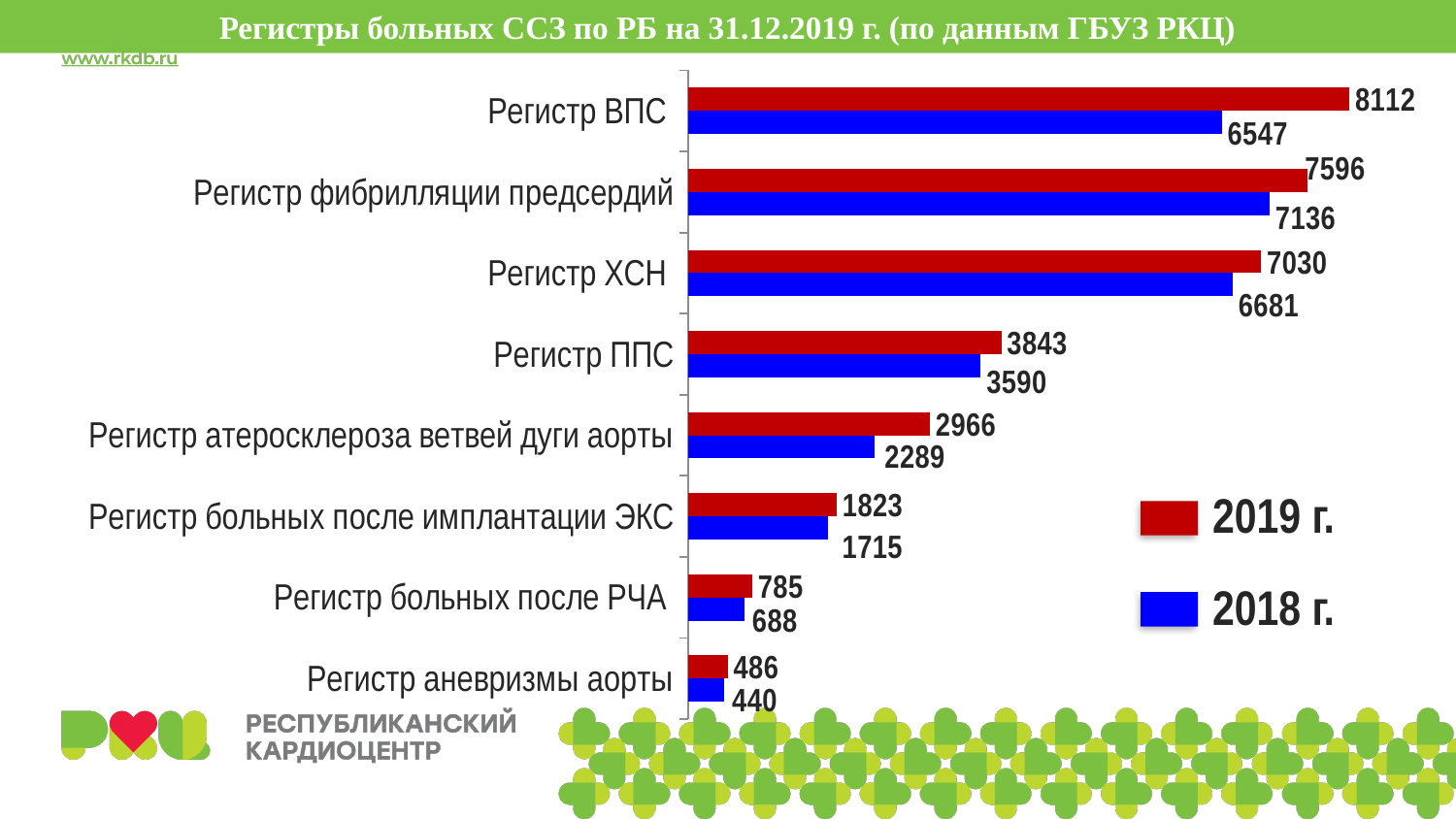
What is the 2019 value for Регистр ВПС? 8112 Which register has the lowest 2018 value? Регистр аневризмы аорты Which register has the highest 2019 value? Регистр ВПС What is the difference between the 2019 and 2018 values for Регистр ВПС? 1565 What is the difference between the 2019 and 2018 values for Регистр больных после РЧА? 97 How many registers (categories) are shown in the chart? 8 How many series does the legend list? 2 What is the 2019 value for Регистр атеросклероза ветвей дуги аорты? 2966 What kind of chart is shown on the slide? Bar chart Which is larger: the 2018 value for Регистр ХСН or the 2019 value for Регистр ППС? 2018 value for Регистр ХСН What is the 2018 value for Регистр фибрилляции предсердий? 7136 What is the 2018 value for Регистр аневризмы аорты? 440